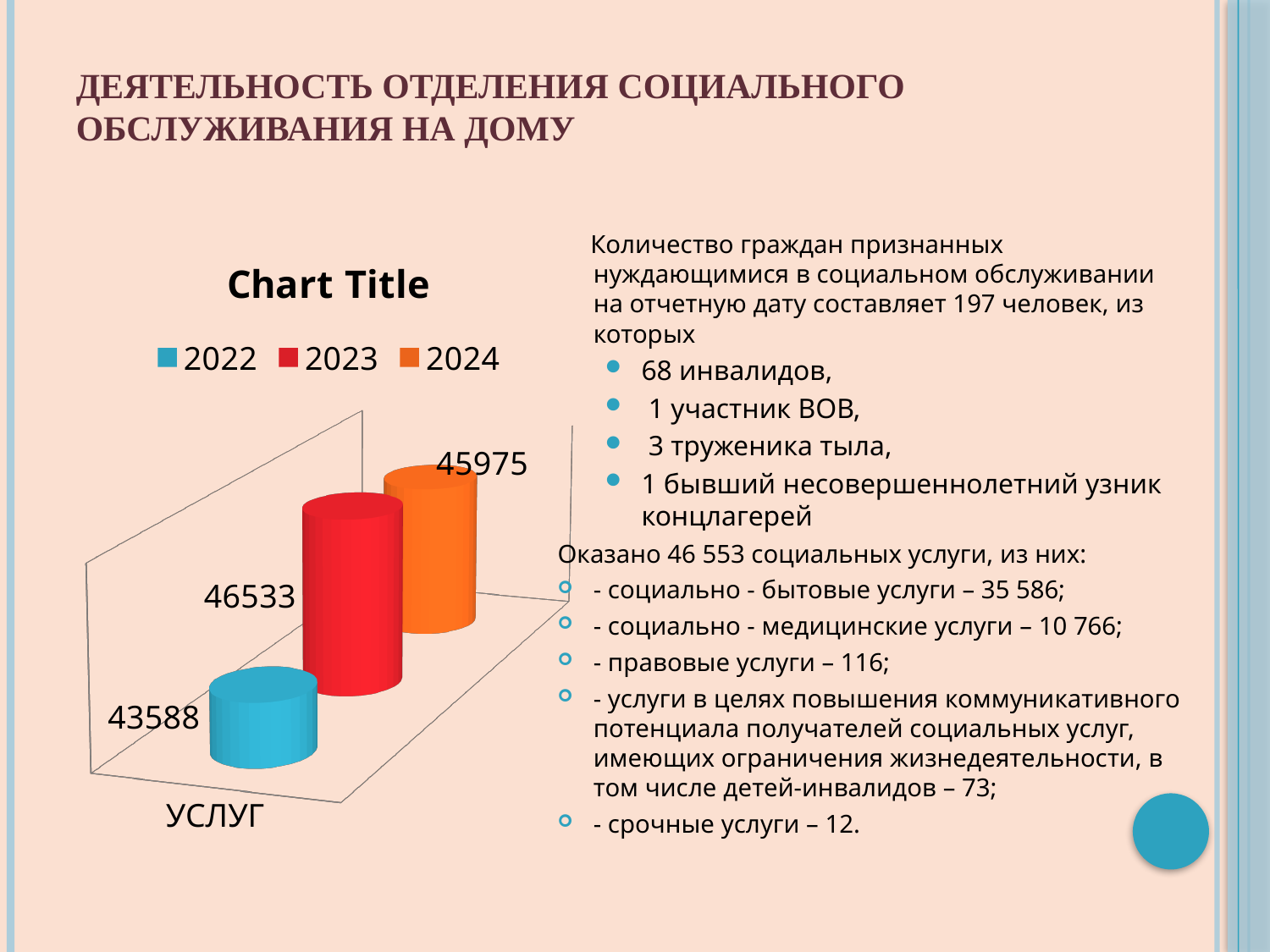
How many series does the legend list? 3 What is the difference between the values for 2023 and 2022? 2945 What colour is the bar for 2024 in the chart? Orange Which year has the highest value in the chart? 2023 What is the value for 2024 in the chart? 45975 What kind of chart is shown on the slide? Bar chart What is the difference between the values for 2023 and 2024? 558 What is the value for 2023 in the chart? 46533 Which is larger, the value for 2024 or the value for 2022? 2024 Which year has the lowest value in the chart? 2022 What is the value for 2022 in the chart? 43588 What is the category label shown on the x axis of the chart? УСЛУГ